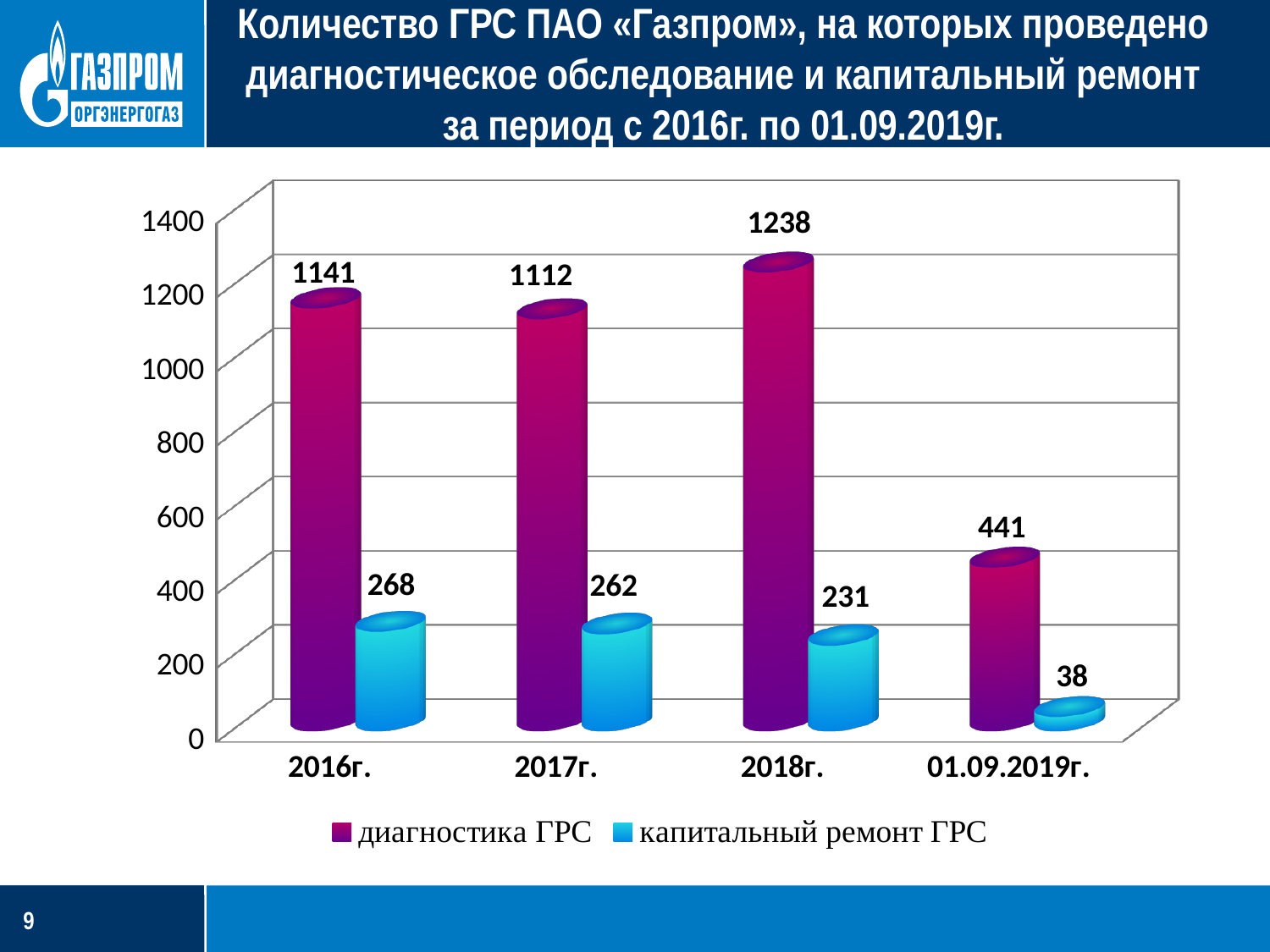
Does the value for капитальный ремонт ГРС rise or fall from 2016г. to 01.09.2019г.? fall What kind of chart is shown on the slide? bar chart How many periods are shown on the x axis? 4 Which is larger: капитальный ремонт ГРС in 2016г. or in 2018г.? 2016г. Which period has the lowest value for капитальный ремонт ГРС? 01.09.2019г. How many series does the legend list? 2 Is the value for диагностика ГРС in 01.09.2019г. greater or less than 600? less What is the difference between диагностика ГРС and капитальный ремонт ГРС in 2018г.? 1007 What is the value for капитальный ремонт ГРС in 01.09.2019г.? 38 What is the value for капитальный ремонт ГРС in 2017г.? 262 What is the value for диагностика ГРС in 2016г.? 1141 Which period has the highest value for диагностика ГРС? 2018г.